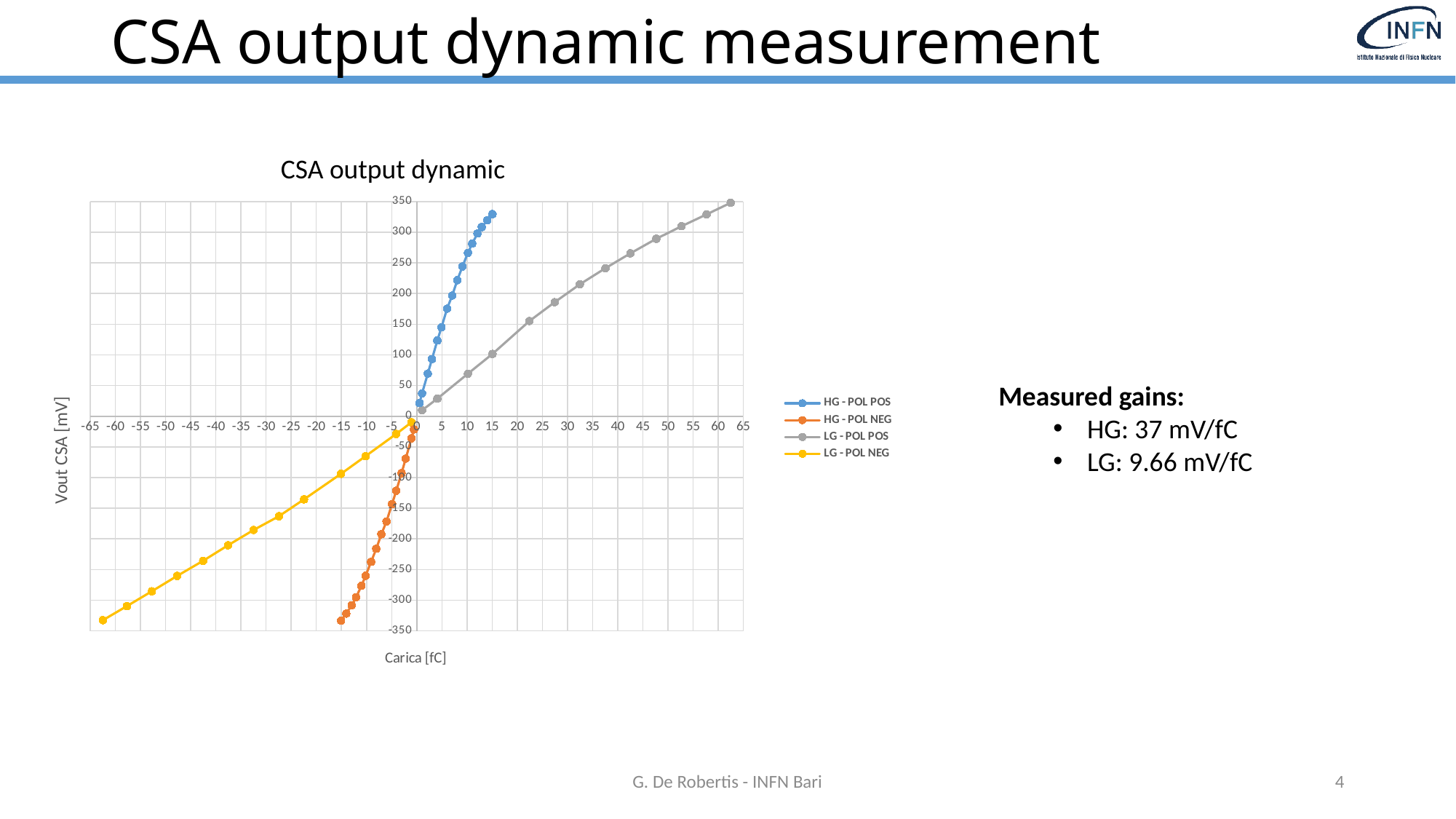
What is the label of the x axis of the chart? Carica [fC] Is the highest value of the LG - POL POS series greater or less than 300? greater Which series extends to the most negative charge on the x axis, HG - POL NEG or LG - POL NEG? LG - POL NEG Which series extends to a larger charge on the x axis, HG - POL POS or LG - POL POS? LG - POL POS Is the lowest value of the LG - POL NEG series greater or less than -300? less Which series has the steeper slope, HG - POL POS or LG - POL POS? HG - POL POS Is the lowest value of the HG - POL NEG series greater or less than -300? less What kind of chart is shown on the slide? line chart How many series does the legend of the chart list? 4 Does the HG - POL POS series rise or fall as the charge increases along the x axis? rise What is the title of the chart? CSA output dynamic